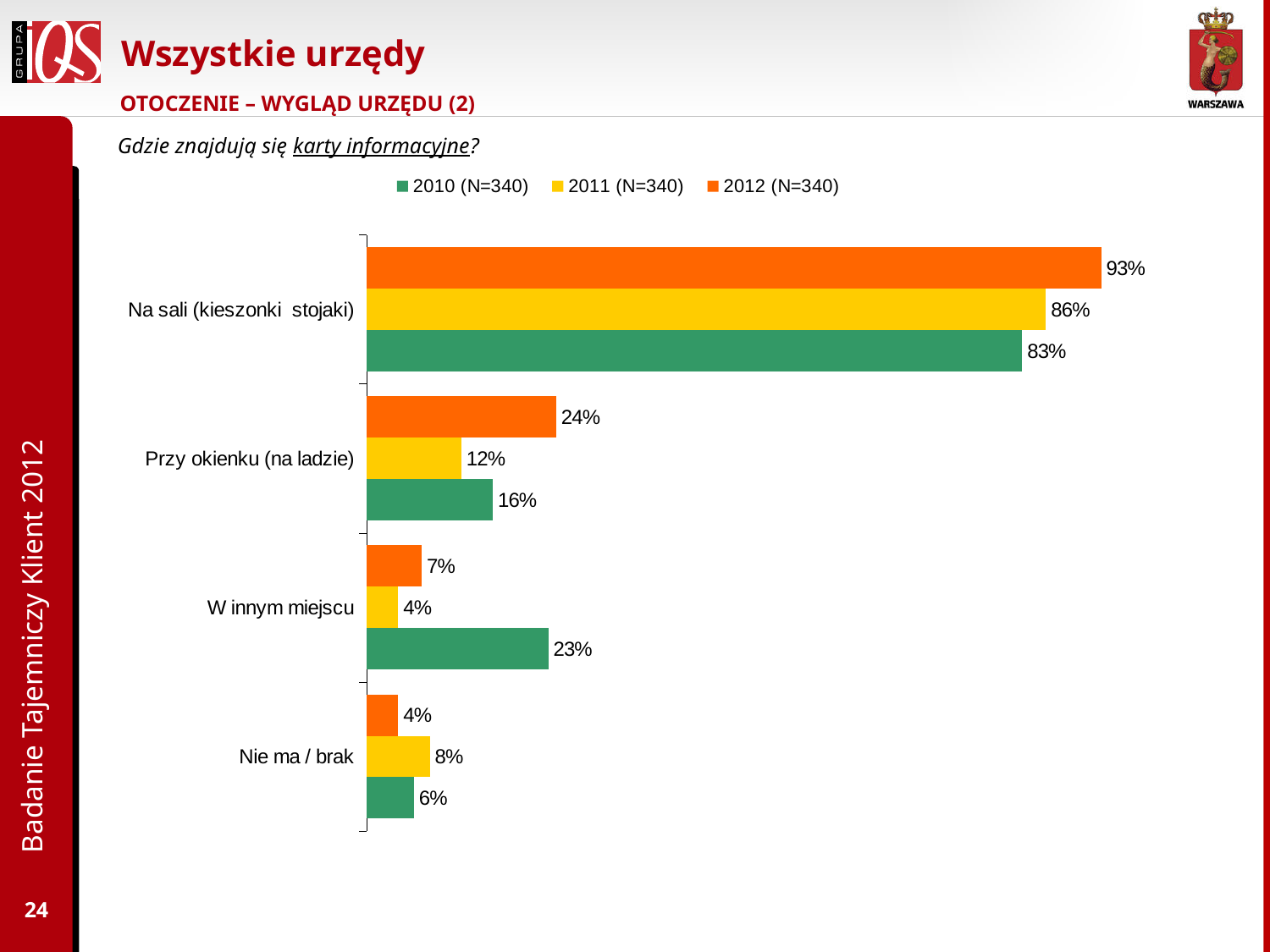
What is the value for "W innym miejscu" in the 2010 (N=340) series? 23% Which category has the lowest value in the 2011 (N=340) series? W innym miejscu For "W innym miejscu", which series has the larger value: 2010 (N=340) or 2012 (N=340)? 2010 (N=340) What is the value for "Nie ma / brak" in the 2012 (N=340) series? 4% How many series does the legend list? 3 What kind of chart is shown on the slide? Bar chart Which category has the highest value in the 2012 (N=340) series? Na sali (kieszonki stojaki) Which colour represents the 2011 (N=340) series in the legend? Yellow How many categories are shown on the chart? 4 What is the difference between the 2012 (N=340) and 2010 (N=340) values for "Na sali (kieszonki stojaki)"? 10% What is the value for "Na sali (kieszonki stojaki)" in the 2012 (N=340) series? 93% What is the value for "Przy okienku (na ladzie)" in the 2011 (N=340) series? 12%